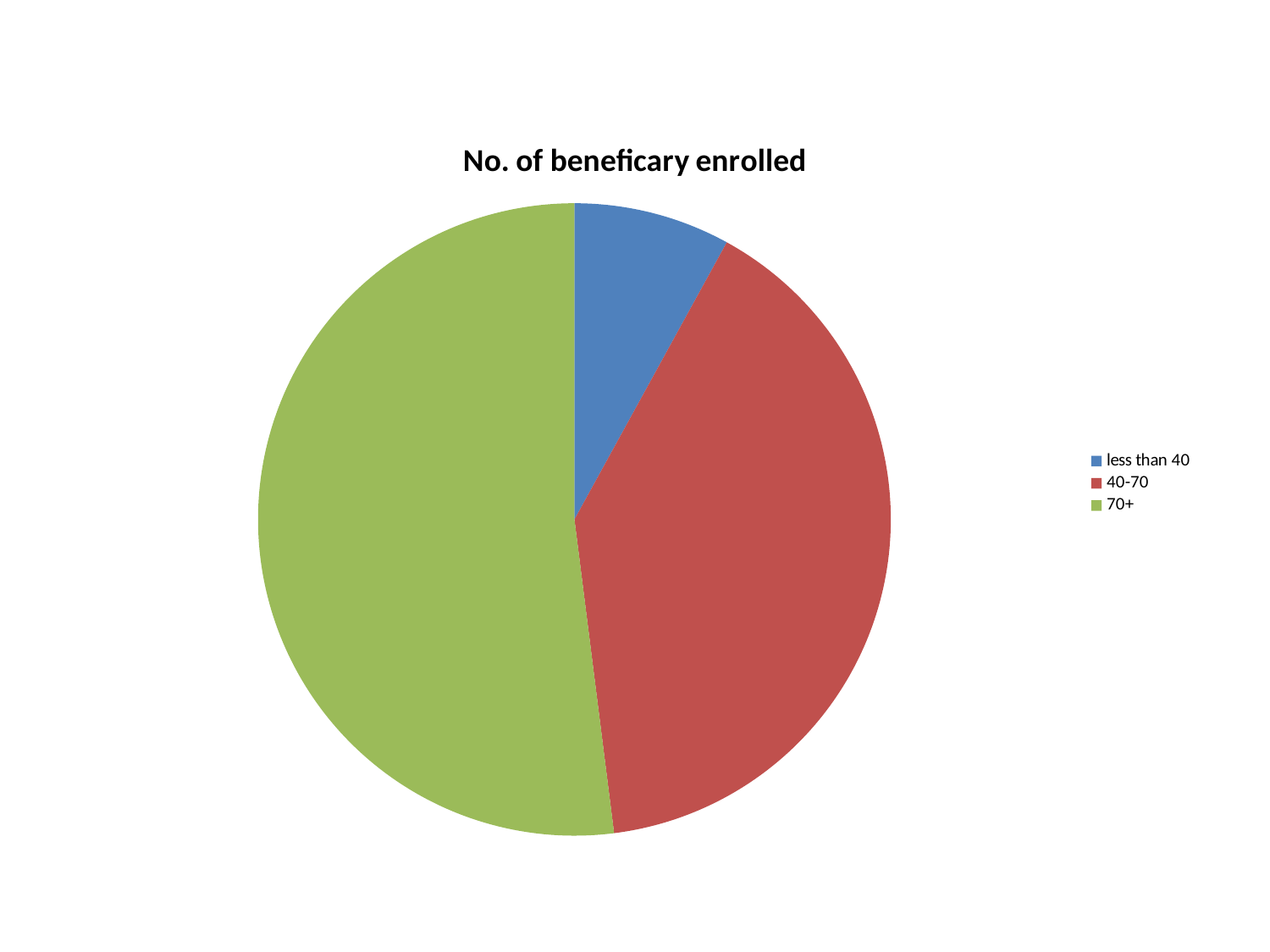
Which slice is larger, 70+ or 40-70? 70+ How many entries does the legend list? 3 What is the title of the chart? No. of beneficary enrolled Which slice is larger, 40-70 or less than 40? 40-70 Which category has the smallest slice of the pie? less than 40 How many slices does the pie chart have? 3 What colour is the slice for the 70+ category? green What kind of chart is shown on the slide? pie chart Which category has the largest slice of the pie? 70+